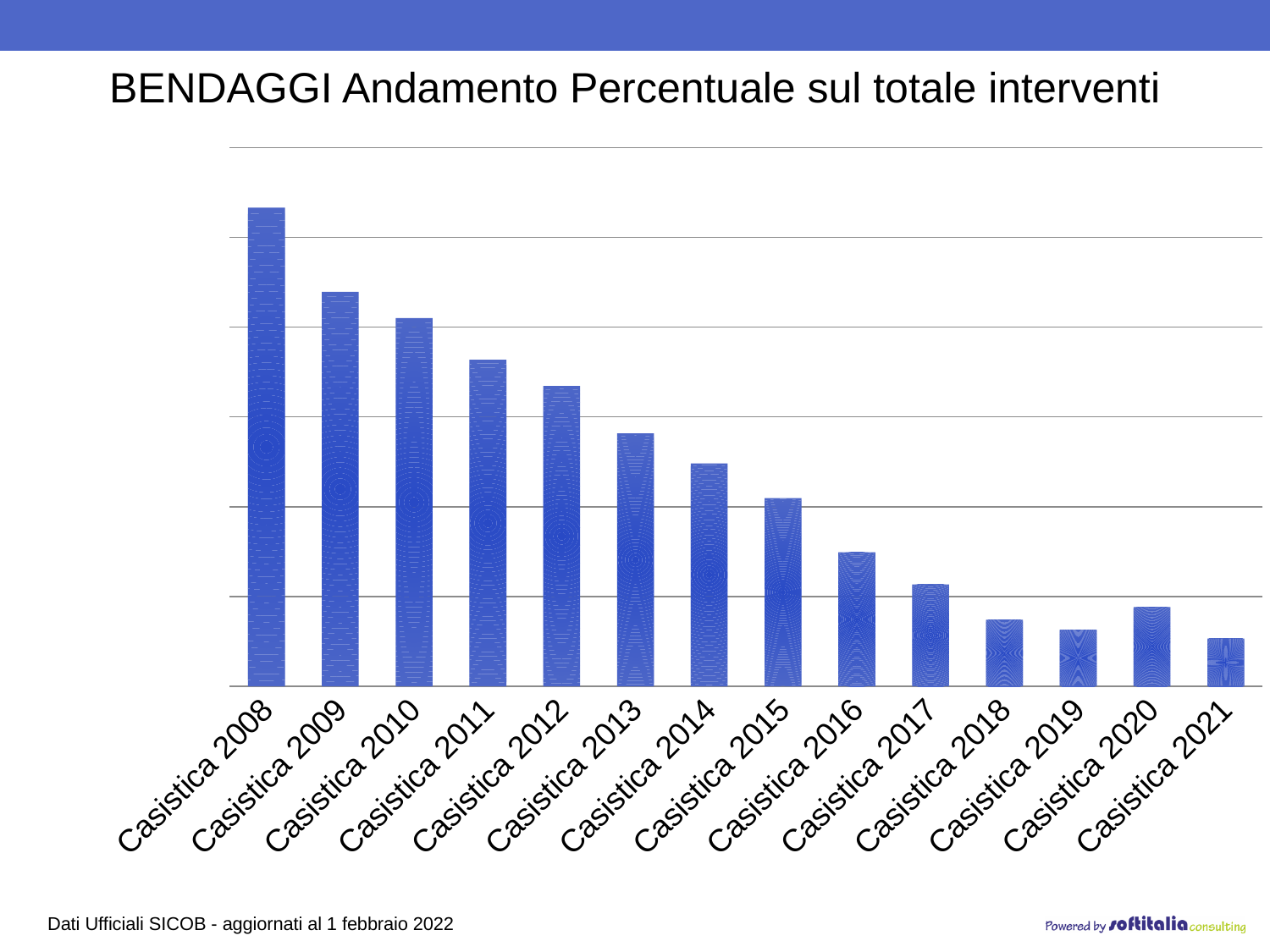
Which category has the highest bar? Casistica 2008 What is the title of the chart? BENDAGGI Andamento Percentuale sul totale interventi Which is larger, the value for Casistica 2013 or Casistica 2014? Casistica 2013 What kind of chart is shown on the slide? Bar chart Which is larger, the value for Casistica 2010 or Casistica 2016? Casistica 2010 Which category has the lowest bar? Casistica 2021 Which is larger, the value for Casistica 2019 or Casistica 2020? Casistica 2020 Do the values generally rise or fall from Casistica 2008 to Casistica 2021? Fall What is the first category on the x axis? Casistica 2008 How many bars (categories) are plotted in the chart? 14